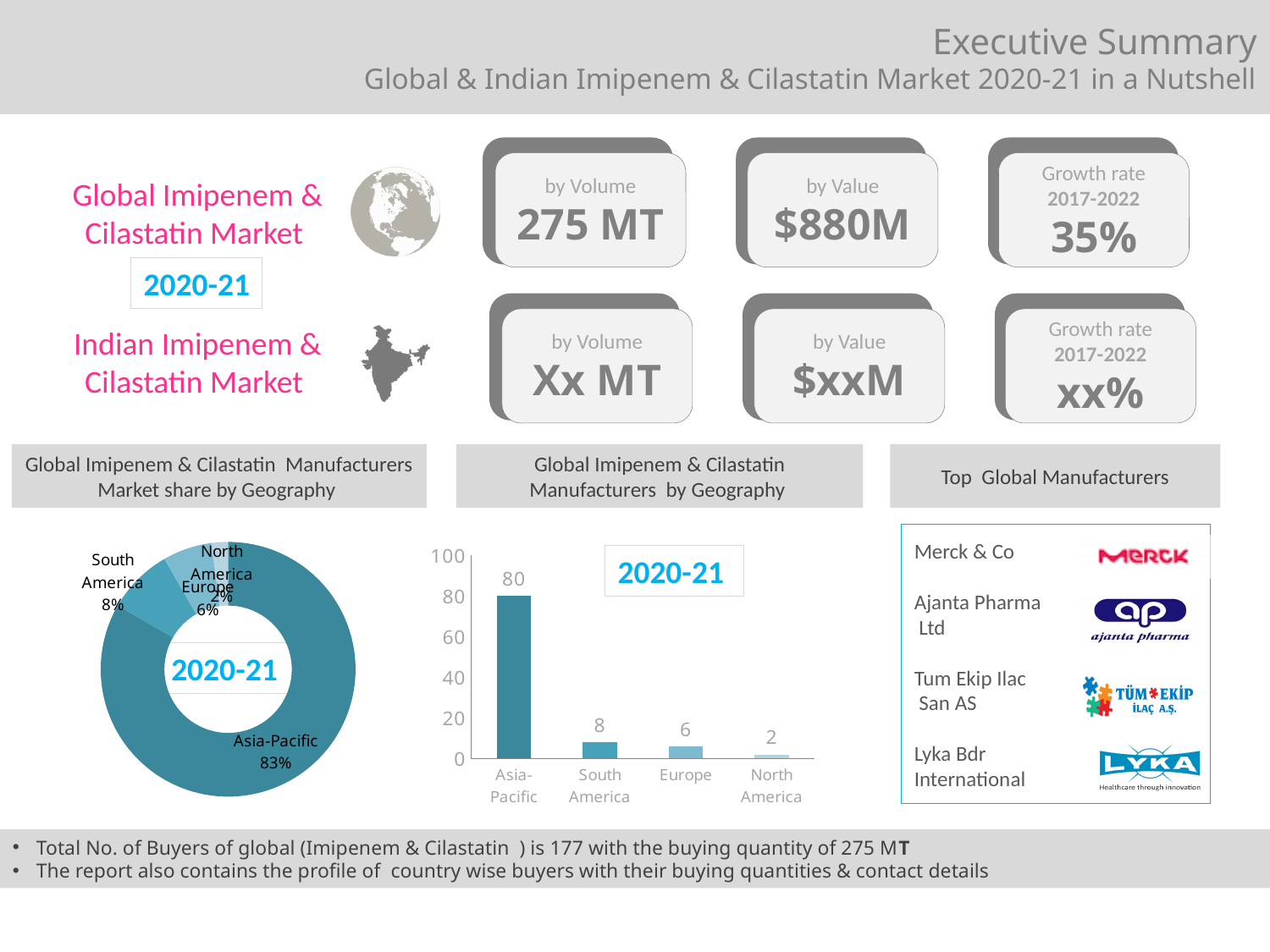
In the donut chart 'Global Imipenem & Cilastatin Manufacturers Market share by Geography', what share does Europe hold? 6% In the bar chart 'Global Imipenem & Cilastatin Manufacturers by Geography', what is the value for North America? 2 In the donut chart 'Global Imipenem & Cilastatin Manufacturers Market share by Geography', what share does Asia-Pacific hold? 83% In the bar chart 'Global Imipenem & Cilastatin Manufacturers by Geography', what is the difference between the values for Asia-Pacific and Europe? 74 What year label is shown in the centre of the donut chart 'Global Imipenem & Cilastatin Manufacturers Market share by Geography'? 2020-21 In the bar chart 'Global Imipenem & Cilastatin Manufacturers by Geography', what is the value for South America? 8 In the bar chart 'Global Imipenem & Cilastatin Manufacturers by Geography', which region has the lowest value? North America In the bar chart 'Global Imipenem & Cilastatin Manufacturers by Geography', which region has the highest value? Asia-Pacific In the donut chart 'Global Imipenem & Cilastatin Manufacturers Market share by Geography', which is larger, the share for South America or the share for North America? South America In the bar chart 'Global Imipenem & Cilastatin Manufacturers by Geography', what is the value for Asia-Pacific? 80 In the bar chart 'Global Imipenem & Cilastatin Manufacturers by Geography', how many regions are shown on the x axis? 4 What type of chart is 'Global Imipenem & Cilastatin Manufacturers by Geography'? Bar chart